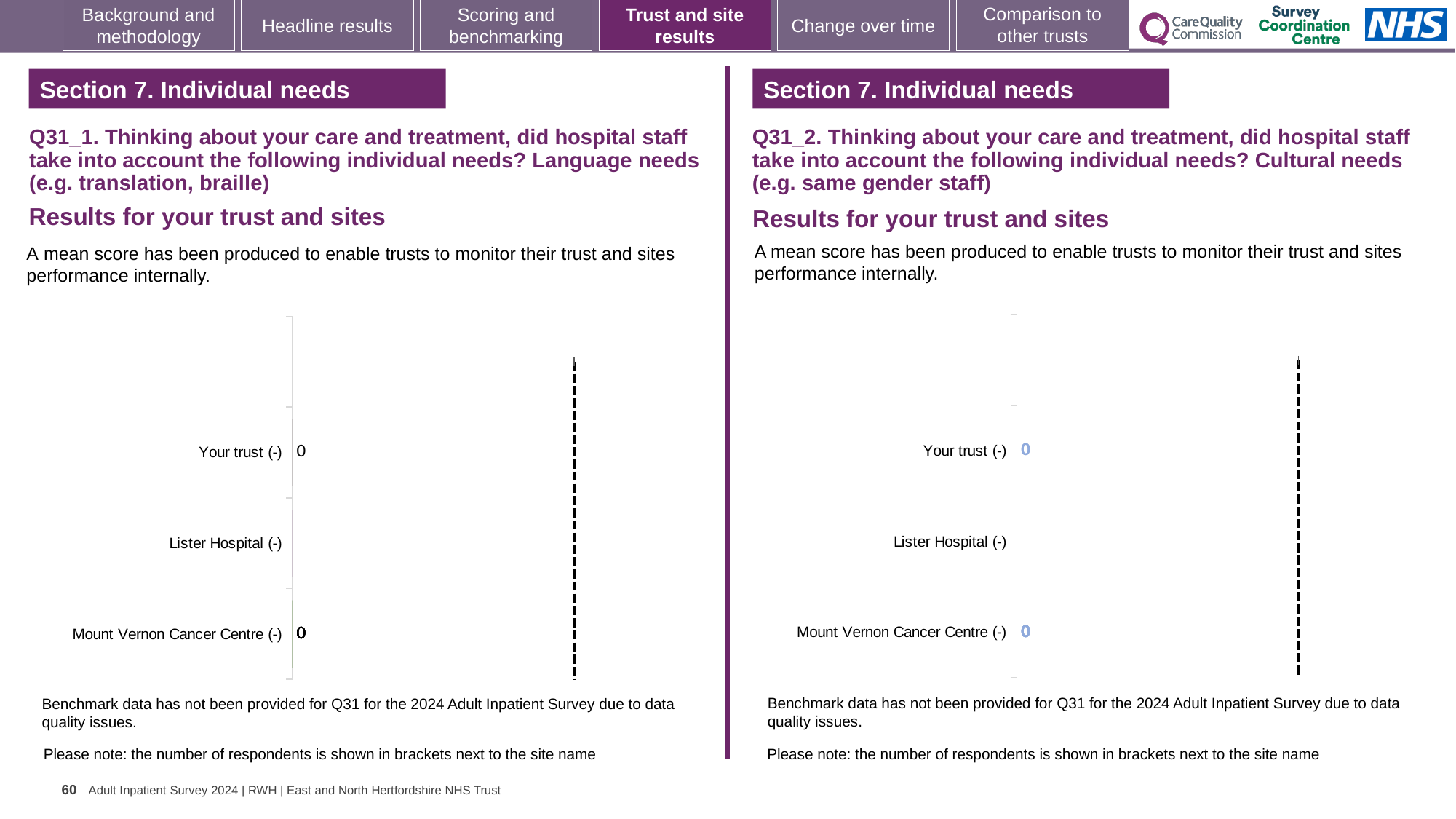
In the right chart (Q31_2, Cultural needs), what value is shown for Your trust (-)? 0 In the left chart (Q31_1, Language needs), how many categories are listed on the vertical axis? 3 In the left chart (Q31_1, Language needs), what is the difference between the values for Your trust (-) and Mount Vernon Cancer Centre (-)? 0 Which category appears at the bottom of the vertical axis in the left chart (Q31_1, Language needs)? Mount Vernon Cancer Centre (-) In the right chart (Q31_2, Cultural needs), what is the difference between the values for Your trust (-) and Mount Vernon Cancer Centre (-)? 0 What kind of chart is the right chart (Q31_2, Cultural needs)? Bar chart In the left chart (Q31_1, Language needs), what value is shown for Your trust (-)? 0 What kind of chart is the left chart (Q31_1, Language needs)? Bar chart In the left chart (Q31_1, Language needs), what value is shown for Mount Vernon Cancer Centre (-)? 0 Which category appears at the top of the vertical axis in the right chart (Q31_2, Cultural needs)? Your trust (-) In the right chart (Q31_2, Cultural needs), what value is shown for Mount Vernon Cancer Centre (-)? 0 In the right chart (Q31_2, Cultural needs), how many categories are listed on the vertical axis? 3